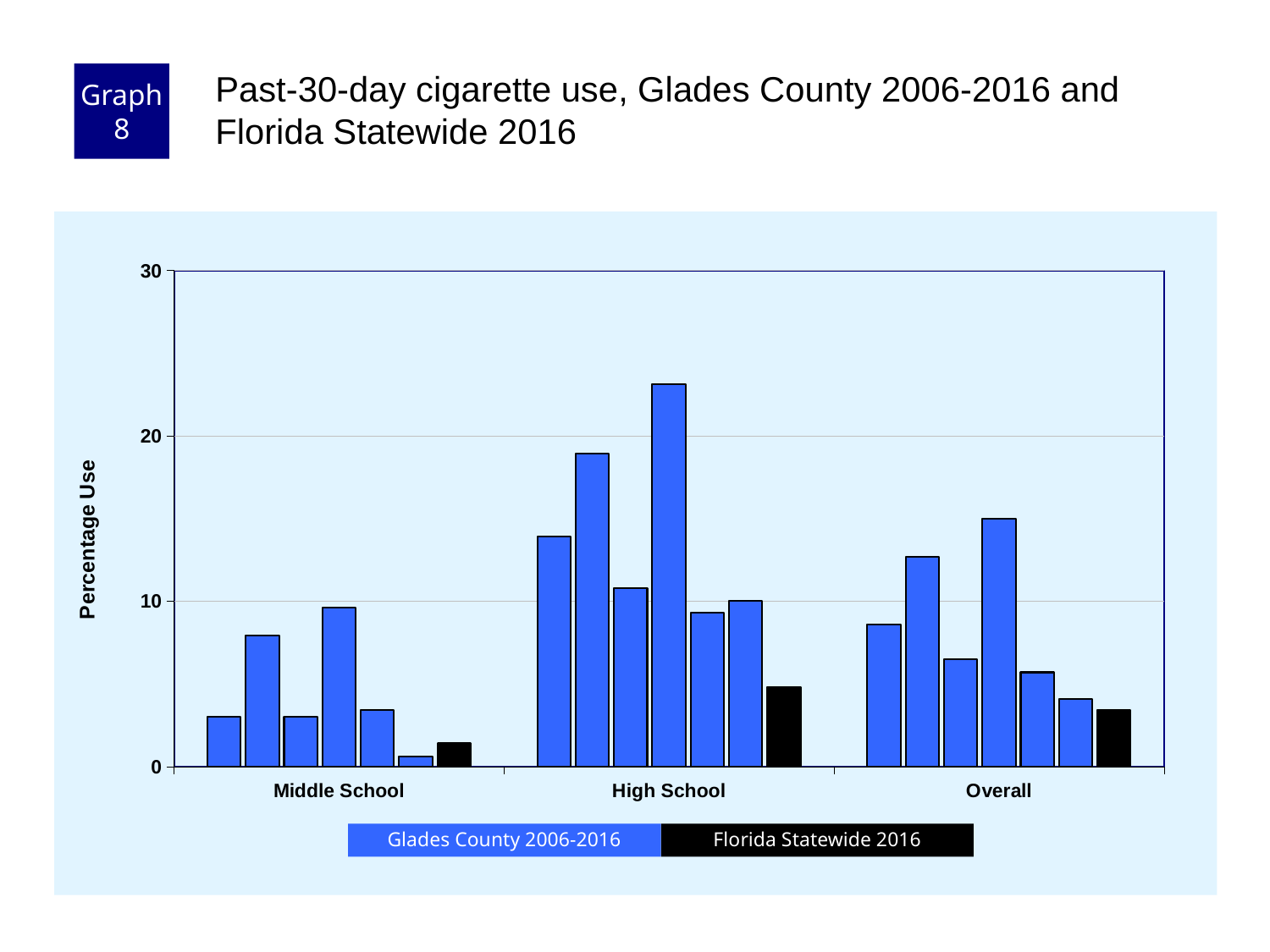
Is the tallest Glades County 2006-2016 bar for Overall greater or less than 20? less How many Glades County 2006-2016 bars are shown in each category group? 6 How many category groups are shown on the x axis? 3 How many series does the legend list? 2 Which category group contains the tallest bar in the chart? High School Is the tallest Glades County 2006-2016 bar for High School greater or less than 20? greater Is the Florida Statewide 2016 value for High School greater or less than 10? less What is the label on the y axis? Percentage Use What colour are the Florida Statewide 2016 bars? black Which is larger, the Florida Statewide 2016 value for High School or for Middle School? High School What kind of chart is shown on the slide? bar chart